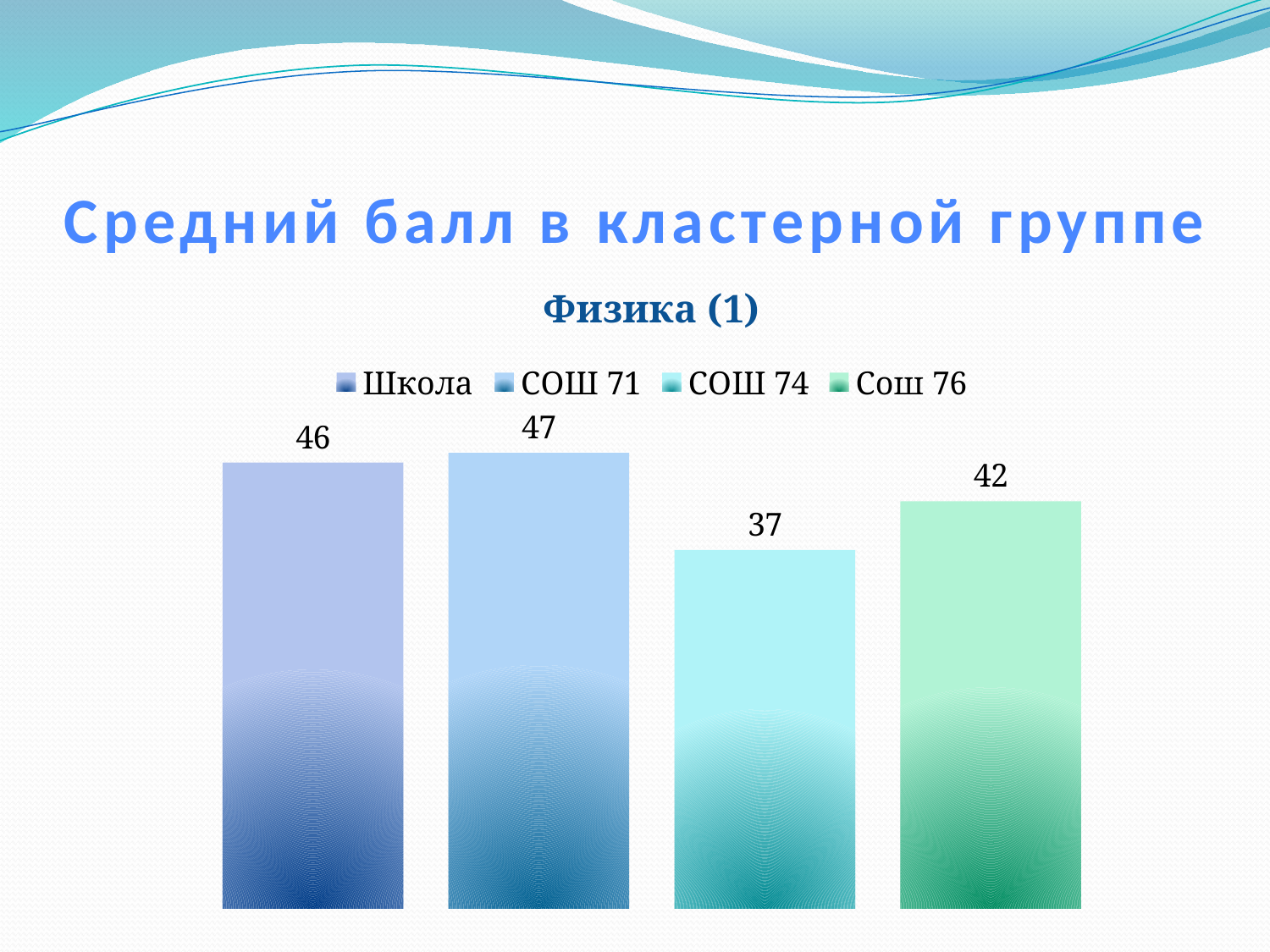
What is the value for Сош 76? 42 What is the difference between the values for СОШ 71 and СОШ 74? 10 How many series does the legend list? 4 What is the difference between the values for Школа and Сош 76? 4 Which series has the highest value? СОШ 71 Which series has the lowest value? СОШ 74 What is the value for СОШ 74? 37 What is the title of the chart? Физика (1) Which is larger, the value for Сош 76 or the value for СОШ 74? Сош 76 What is the value for СОШ 71? 47 What kind of chart is shown on the slide? bar chart What is the value for Школа? 46